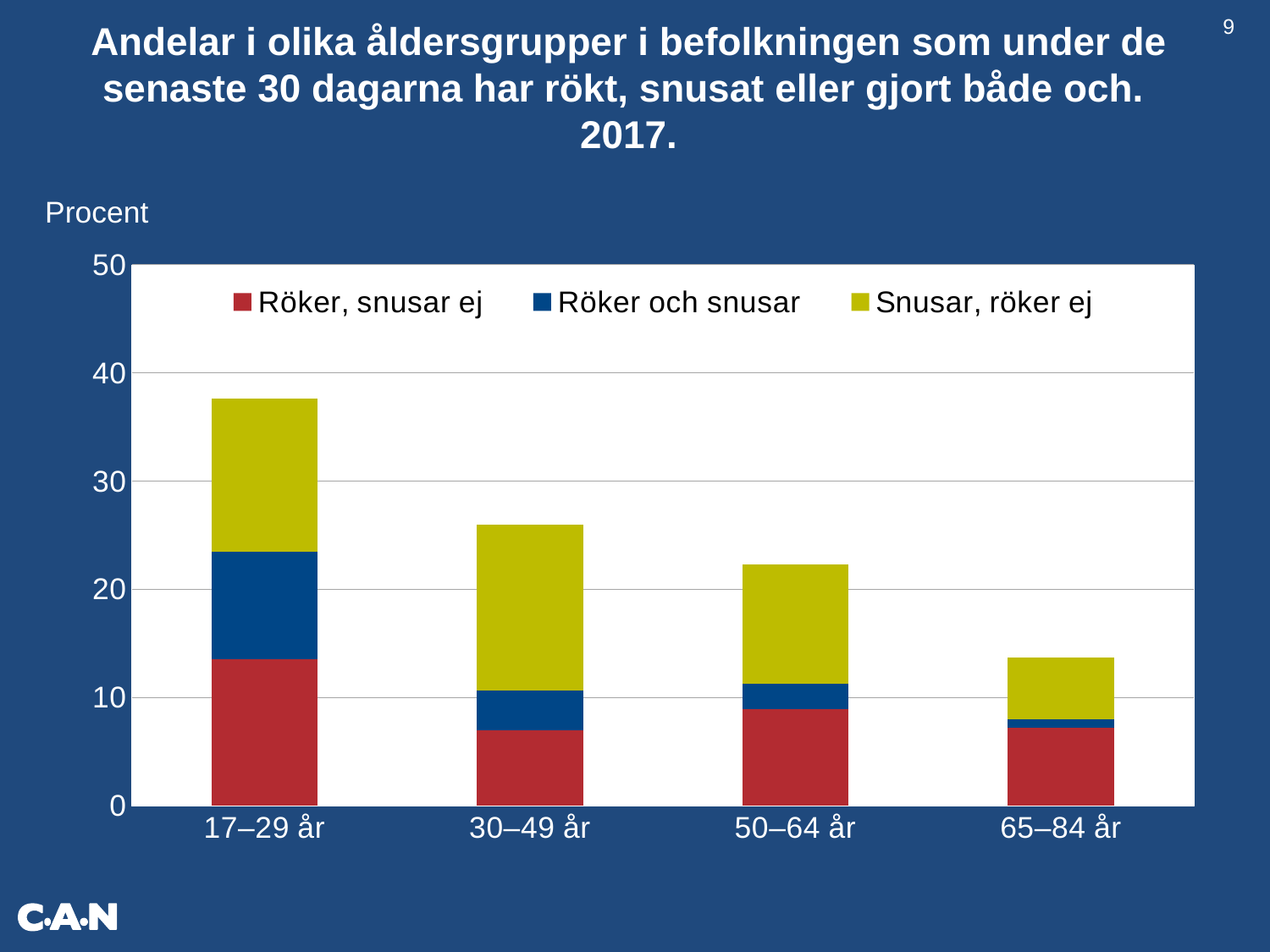
Which total bar is larger, 30–49 år or 50–64 år? 30–49 år What kind of chart is shown on the slide? Stacked bar chart Is the 'Röker, snusar ej' segment for 17–29 år greater or less than 10? greater Which age group has the lowest total bar? 65–84 år How many series does the legend list? 3 Do the total bars rise or fall as age group increases along the x axis? fall How many age groups are shown on the x axis? 4 Is the total bar for 65–84 år greater or less than 20? less Is the total bar for 17–29 år greater or less than 30? greater What label is shown above the y axis? Procent Which age group has the highest total bar? 17–29 år